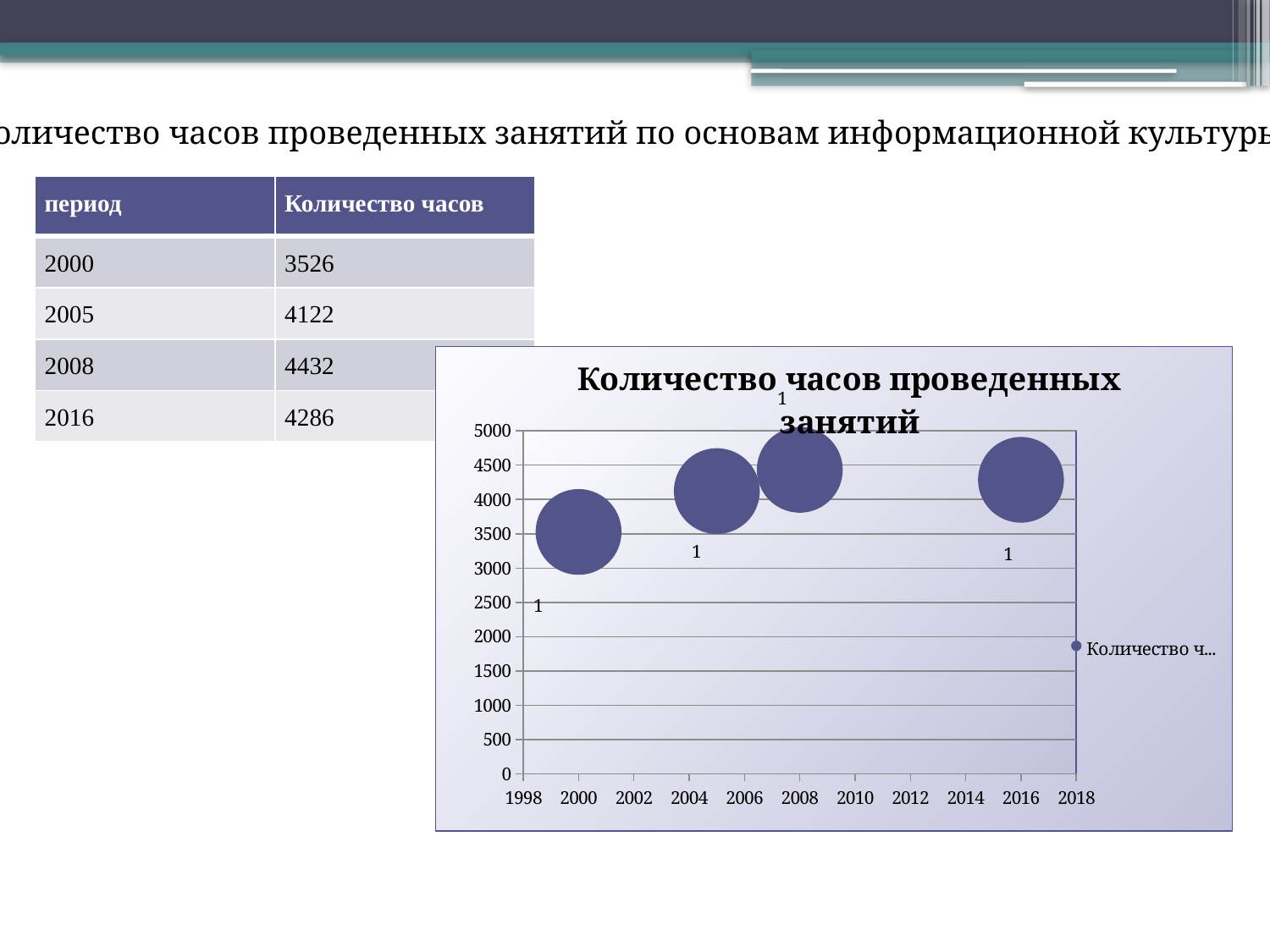
Is the value for 2000 in the chart greater or less than 4000? less How many series does the chart legend list? 1 Which is larger in the chart, the value for 2000 or the value for 2016? 2016 What is the title of the chart? Количество часов проведенных занятий Which year has the lowest number of hours in the chart? 2000 Which year has the highest number of hours in the chart? 2008 Is the value for 2008 in the chart greater or less than 4000? greater According to the table on the slide, how many hours were held in 2008? 4432 What kind of chart is shown on the slide? bubble chart How many bubbles (data points) are plotted in the chart? 4 Using the values in the table on the slide, what is the difference between the hours for 2008 and 2000? 906 Is the value for 2016 in the chart greater or less than 3500? greater